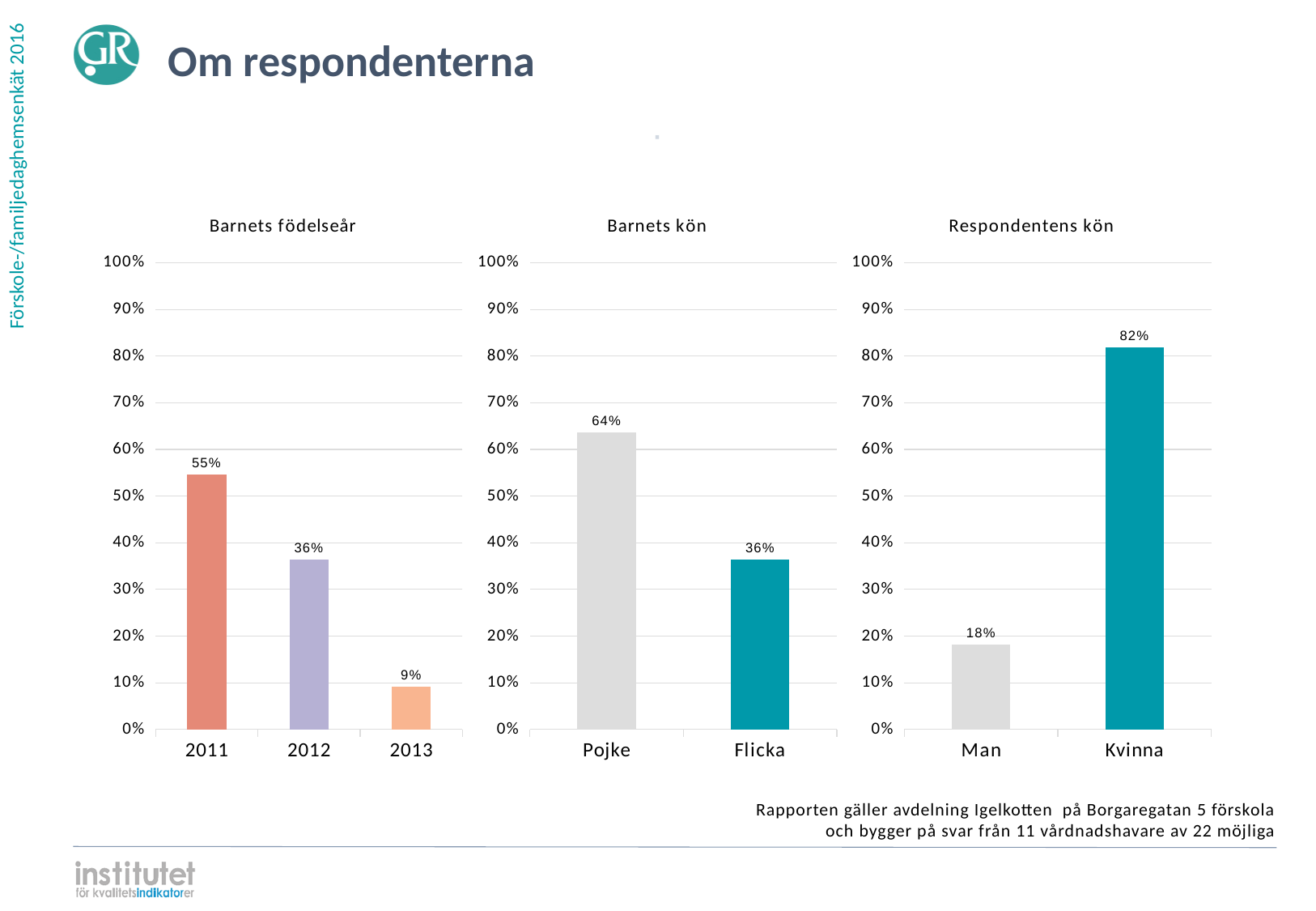
In the 'Barnets födelseår' chart, what is the difference between the values for 2011 and 2012? 19% In the 'Respondentens kön' chart, is the value for Man greater or less than 20%? less What kind of chart is the 'Respondentens kön' chart? bar chart In the 'Barnets födelseår' chart, do the values rise or fall from 2011 to 2013? fall In the 'Barnets födelseår' chart, how many categories are shown? 3 In the 'Respondentens kön' chart, what is the value for Kvinna? 82% In the 'Barnets kön' chart, what is the difference between Pojke and Flicka? 28% In the 'Barnets födelseår' chart, which year has the lowest value? 2013 In the 'Barnets kön' chart, which category is higher, Pojke or Flicka? Pojke In the 'Respondentens kön' chart, what is the value for Man? 18% In the 'Barnets kön' chart, what is the value for Pojke? 64% In the 'Barnets födelseår' chart, what is the value for 2011? 55%